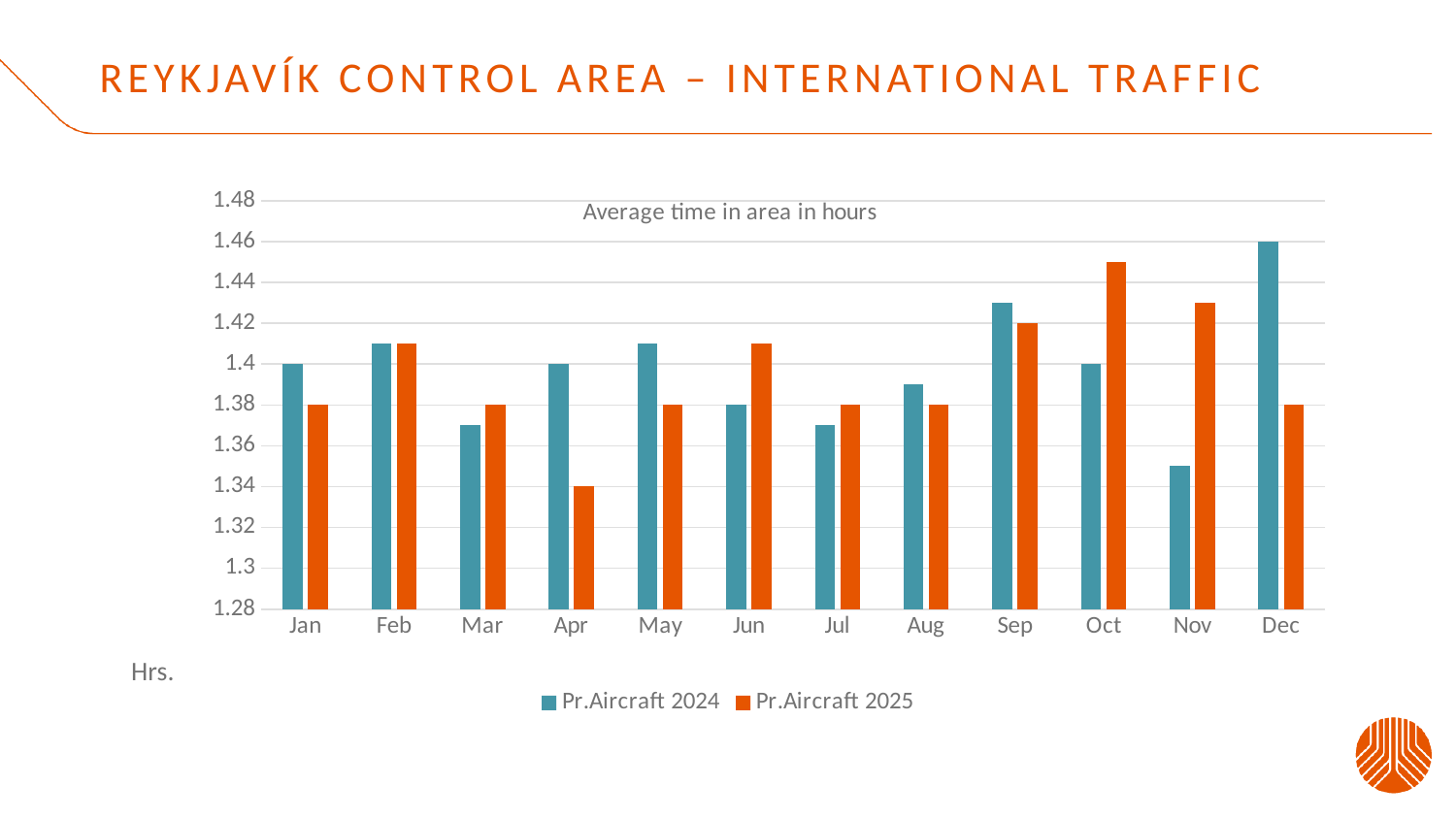
Which month has the lowest value for Pr.Aircraft 2024? Nov Is the value for Pr.Aircraft 2024 in Dec greater or less than 1.44? greater How many months are shown on the x axis? 12 Which month has the highest value for Pr.Aircraft 2024? Dec How many series does the legend list? 2 Is the value for Pr.Aircraft 2025 in Apr greater or less than 1.36? less In Dec, which series has the larger value, Pr.Aircraft 2024 or Pr.Aircraft 2025? Pr.Aircraft 2024 What kind of chart is shown on the slide? Bar chart In Oct, which series has the larger value, Pr.Aircraft 2024 or Pr.Aircraft 2025? Pr.Aircraft 2025 What is the title shown inside the chart? Average time in area in hours Which month has the lowest value for Pr.Aircraft 2025? Apr Which month has the highest value for Pr.Aircraft 2025? Oct